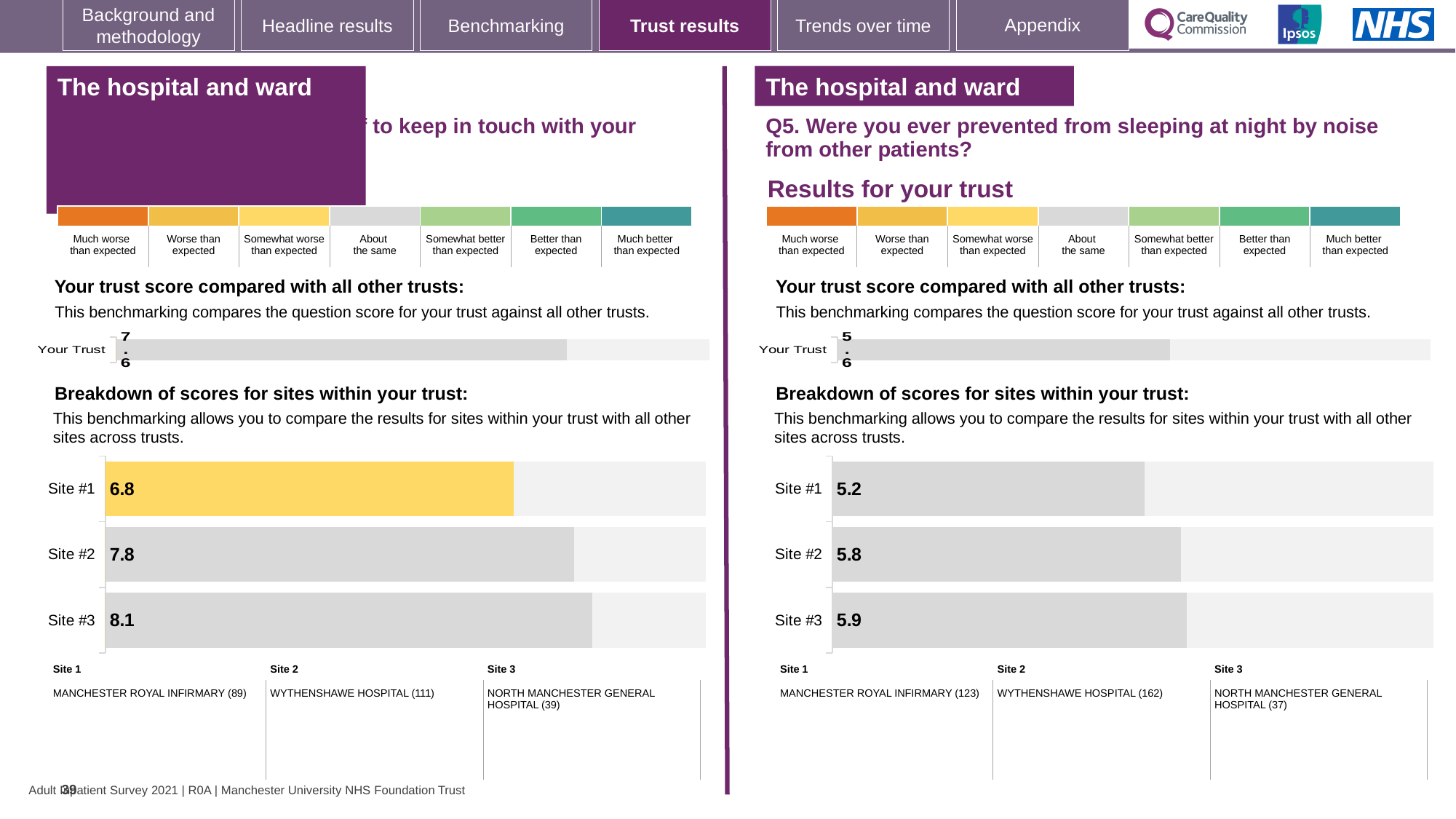
On the left-hand slide, which site has the highest score in the site breakdown chart? Site #3 On the right-hand slide (Q5), what is the score for Site #3 in the site breakdown chart? 5.9 On the right-hand slide (Q5), which site has the lowest score in the site breakdown chart? Site #1 On the right-hand slide (Q5), what is the difference between the Site #2 score and the Site #1 score in the site breakdown chart? 0.6 On the right-hand slide (Q5), what is the score for Site #1 in the breakdown of scores for sites within your trust? 5.2 On the left-hand slide, which is larger in the site breakdown chart: the score for Site #1 or Site #2? Site #2 On the right-hand slide (Q5), what is the 'Your Trust' score in the trust comparison chart? 5.6 How many sites are shown in the site breakdown chart on the right-hand slide (Q5)? 3 What type of chart is used for the breakdown of scores for sites on the left-hand slide? Bar chart On the left-hand slide, what is the difference between the Site #3 score and the Site #1 score in the site breakdown chart? 1.3 On the left-hand slide, what is the score for Site #2 in the site breakdown chart? 7.8 On the left-hand slide, what is the 'Your Trust' score in the trust comparison chart? 7.6